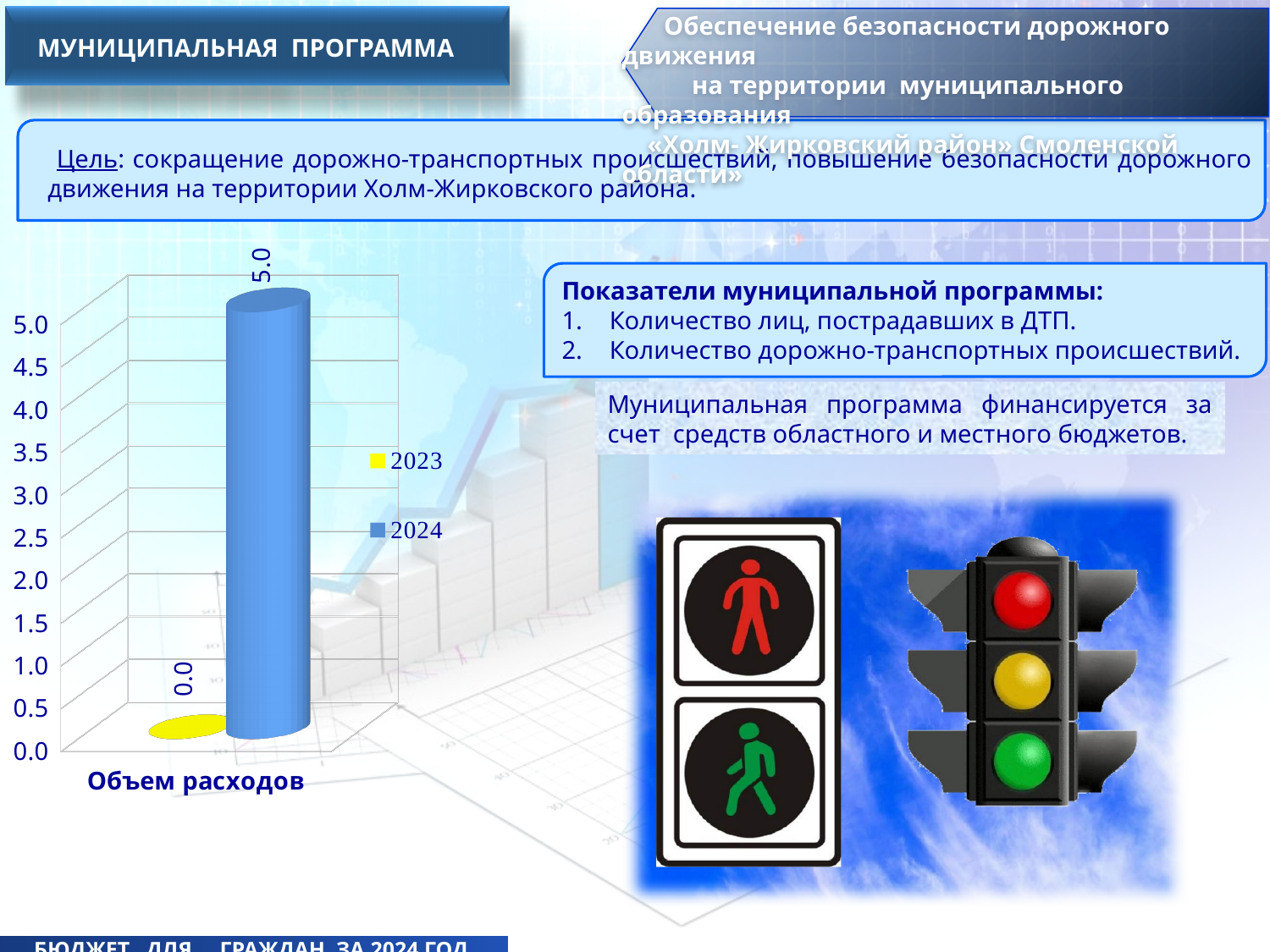
What kind of chart is shown on the slide? bar chart What is the category label shown under the chart? Объем расходов What is the value for 2023 in the chart? 0.0 What is the highest value shown on the chart's vertical axis? 5.0 How many series does the chart legend list? 2 What is the value for 2024 in the chart? 5.0 Which series has the lowest value in the chart? 2023 Is the value for 2024 greater or less than 4.0? greater Which series has the higher value, 2023 or 2024? 2024 How many categories are plotted on the x axis of the chart? 1 Which colour represents the 2024 series in the chart? blue What is the difference between the 2024 and 2023 values? 5.0